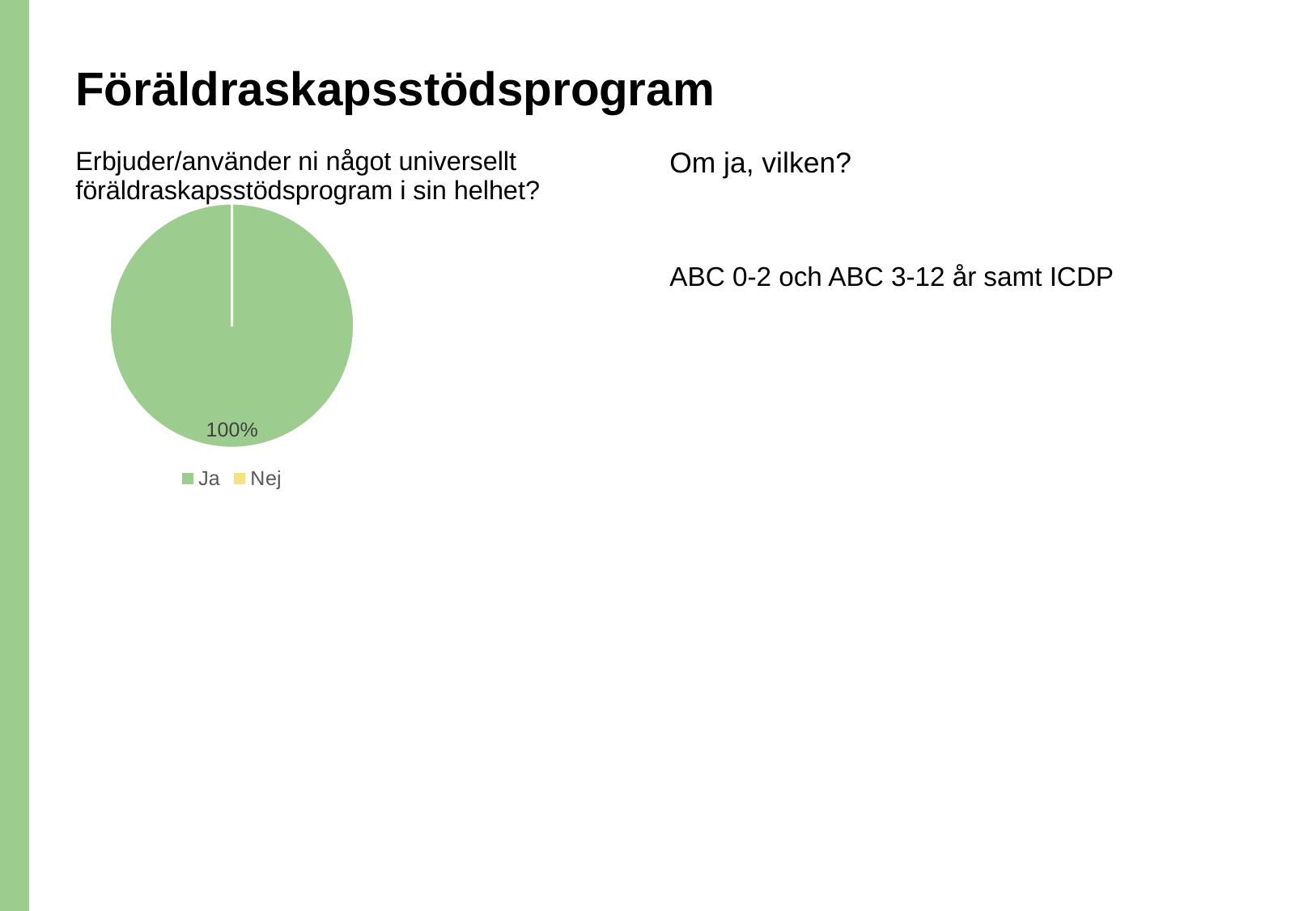
What colour is used for the "Ja" category in the pie chart? green What is the only percentage label printed on the pie chart? 100% What are the two legend entries of the pie chart? Ja, Nej Which category has the largest share of the pie? Ja What share of the pie does the "Ja" slice represent? 100% How many categories does the legend of the pie chart list? 2 Which of the two categories, "Ja" or "Nej", has the larger share of the pie? Ja What kind of chart is shown on the slide? pie chart